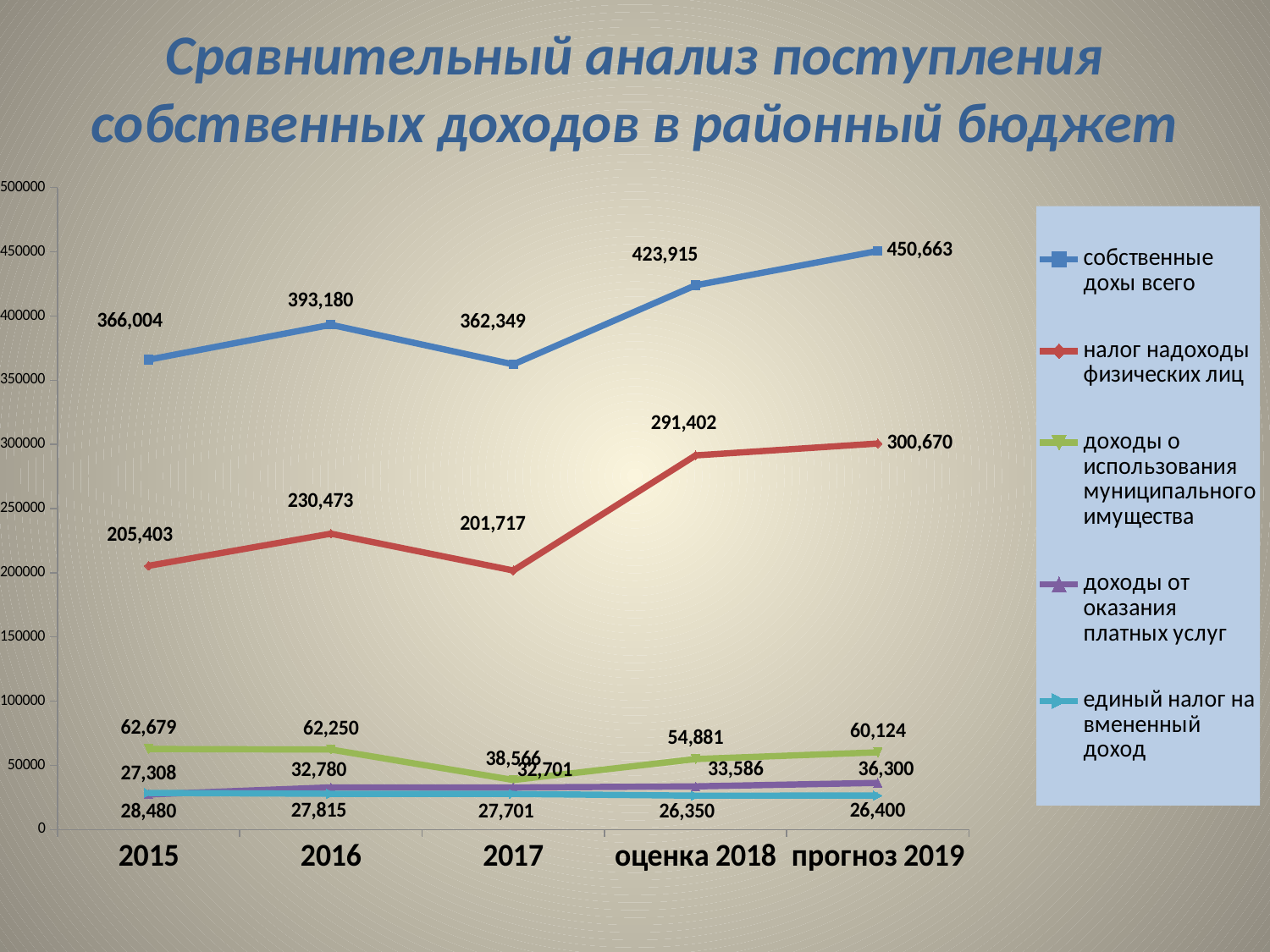
Which is larger for налог на доходы физических лиц: 2016 or 2017? 2016 What is the value of налог на доходы физических лиц for прогноз 2019? 300,670 In which period is собственные доходы всего highest? прогноз 2019 What kind of chart is shown on the slide? line chart How many periods are shown on the x axis? 5 What is the value of собственные доходы всего in 2017? 362,349 What is the value of доходы от оказания платных услуг for прогноз 2019? 36,300 In which period is доходы от использования муниципального имущества lowest? 2017 Is the value of собственные доходы всего in 2015 greater or less than 350000? greater What is the difference between собственные доходы всего for прогноз 2019 and оценка 2018? 26,748 How many series does the legend list? 5 What is the value of доходы от использования муниципального имущества in 2015? 62,679